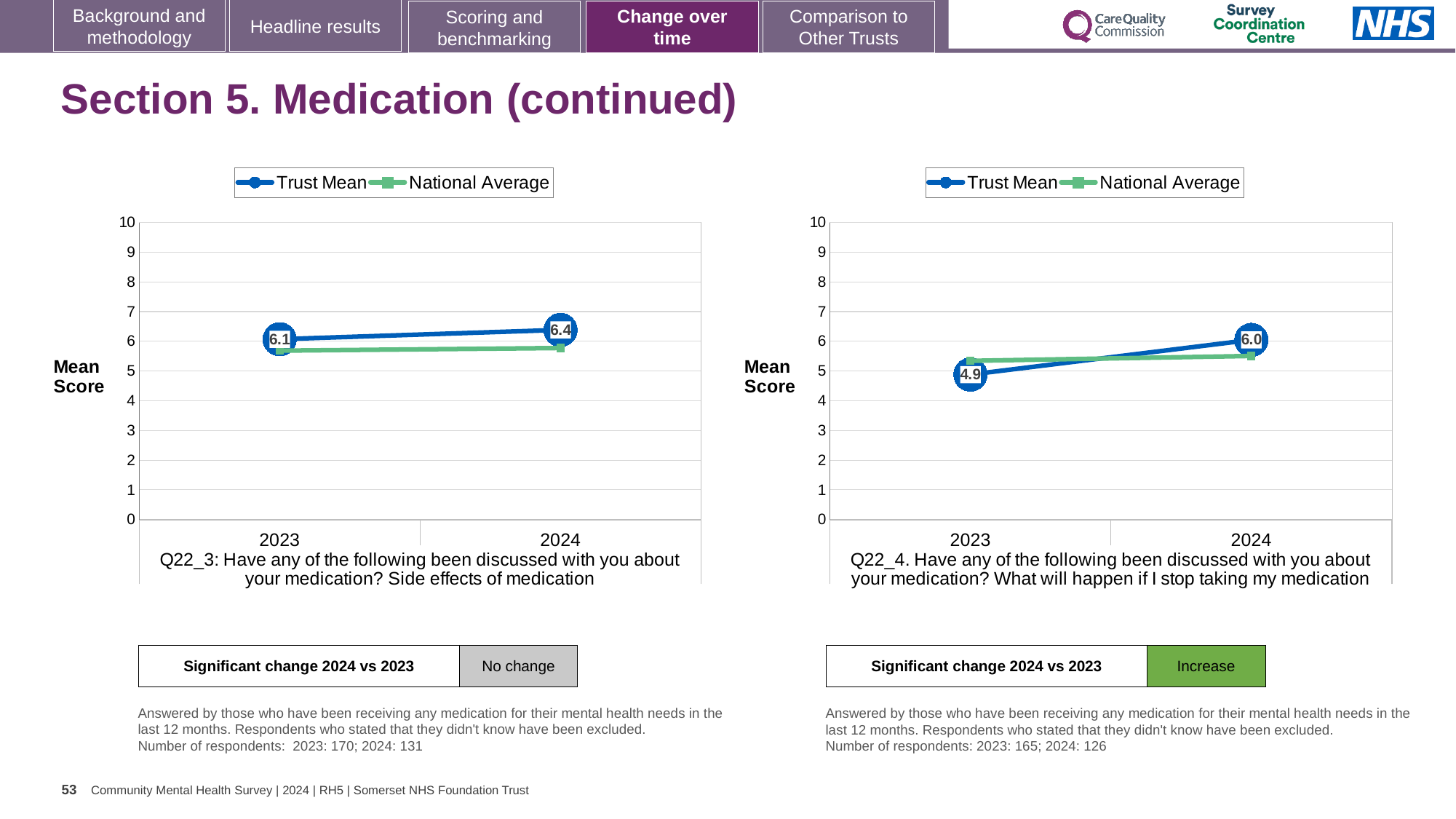
What type of chart is used on the left of the slide (Q22_3)? line chart In the right chart (Q22_4), does the Trust Mean rise or fall from 2023 to 2024? rise In the right chart (Q22_4), by how much did the Trust Mean change from 2023 to 2024? 1.1 In the right chart (Q22_4), which is larger in 2023: the Trust Mean or the National Average? National Average How many series does the legend of the right chart (Q22_4) list? 2 In the right chart (Q22_4), is the National Average for 2023 greater or less than 5? greater In the left chart (Q22_3), what is the difference between the Trust Mean in 2024 and 2023? 0.3 In the right chart (Q22_4), what is the Trust Mean score for 2024? 6.0 How many years are shown on the x axis of the left chart (Q22_3)? 2 In the left chart (Q22_3), what is the Trust Mean score for 2024? 6.4 In the right chart (Q22_4), what is the Trust Mean score for 2023? 4.9 In the left chart (Q22_3), what is the Trust Mean score for 2023? 6.1